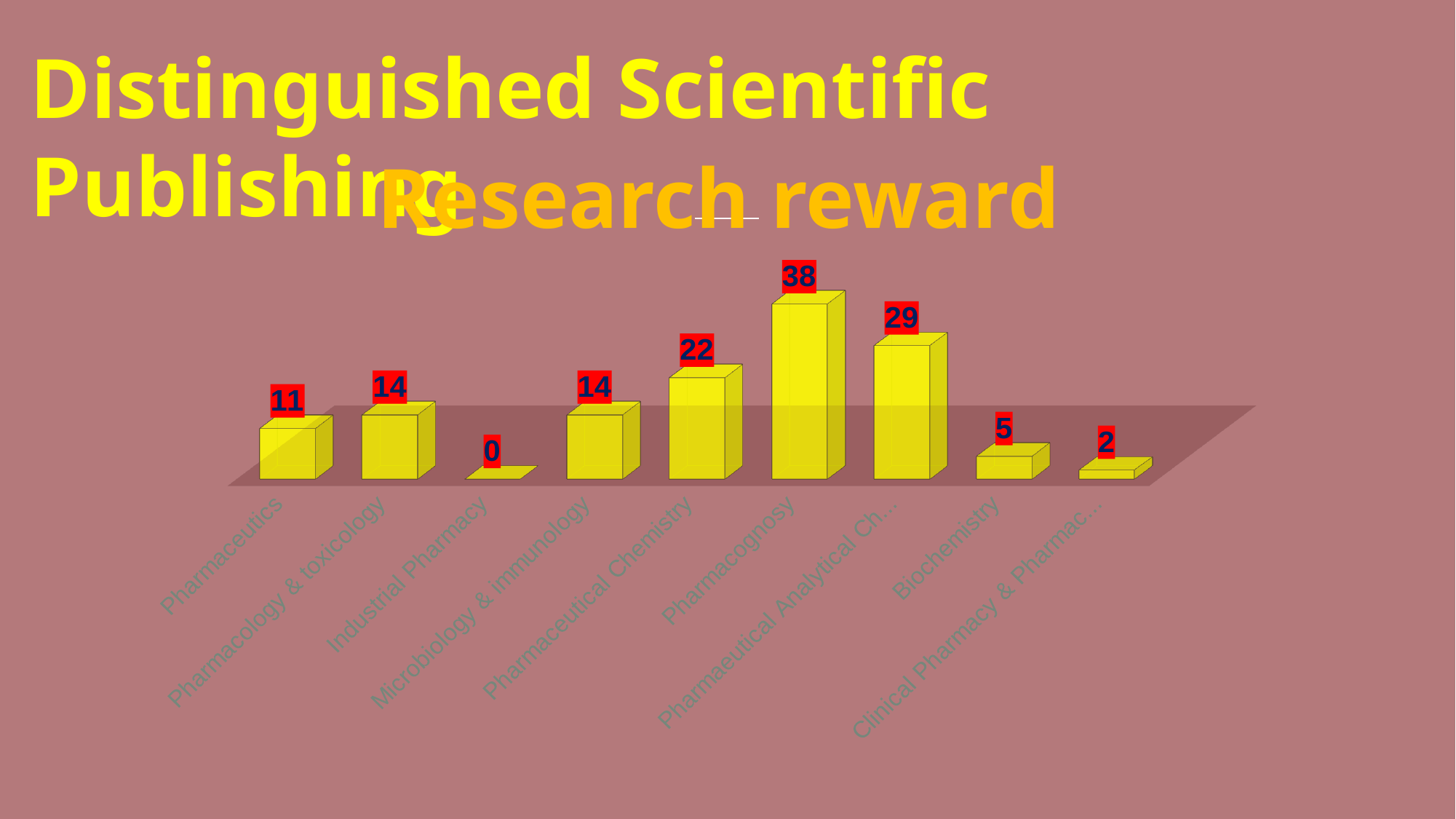
What is the difference between the values for Pharmacognosy and Pharmaceutical Chemistry? 16 What is the value for Pharmaceutical Chemistry? 22 What is the value for Pharmacognosy? 38 What kind of chart is shown on the slide? Bar chart How many categories are shown in the chart? 9 What is the value for Biochemistry? 5 What is the value for Industrial Pharmacy? 0 Which category has the highest value? Pharmacognosy What colour are the bars in the chart? Yellow What is the value for Pharmaceutics? 11 Which category has the lowest value? Industrial Pharmacy Which is larger, the value for Pharmacology & toxicology or the value for Biochemistry? Pharmacology & toxicology